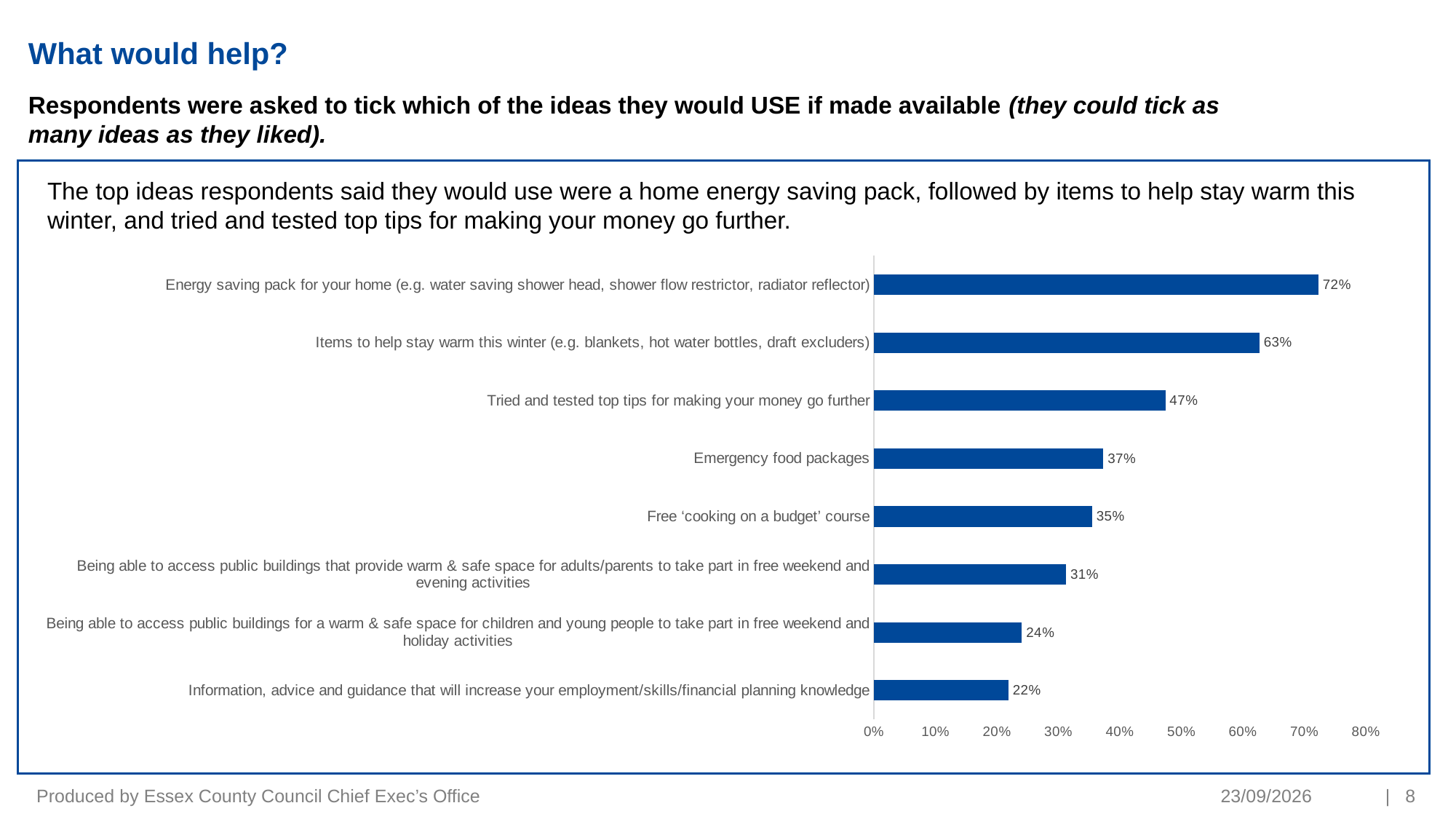
What is the value for the idea about accessing public buildings for children and young people to take part in free weekend and holiday activities? 24% Which idea has the highest percentage of respondents saying they would use it? Energy saving pack for your home What is the value for 'Emergency food packages'? 37% What is the maximum value shown on the chart's percentage axis? 80% Which idea has the lowest percentage? Information, advice and guidance that will increase your employment/skills/financial planning knowledge What is the value for 'Free 'cooking on a budget' course'? 35% What percentage of respondents said they would use an energy saving pack for their home? 72% Which is larger: the value for 'Tried and tested top tips for making your money go further' or the value for 'Emergency food packages'? Tried and tested top tips for making your money go further Is the value for 'Items to help stay warm this winter' greater or less than 60%? greater What type of chart is shown on the slide? Bar chart How many ideas are shown in the chart? 8 What is the difference in percentage points between 'Energy saving pack for your home' and 'Items to help stay warm this winter'? 9 percentage points